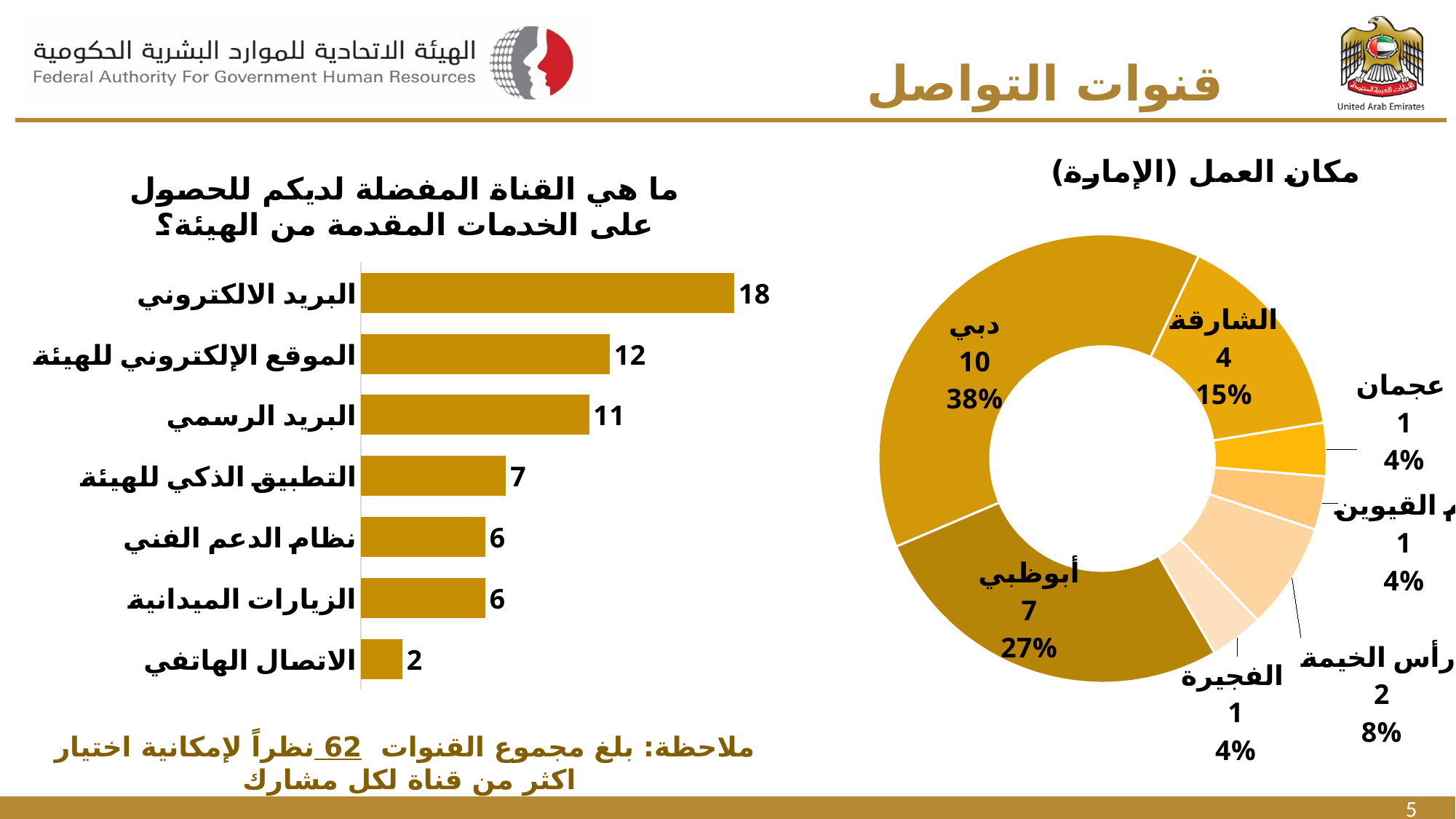
In the bar chart on the left, what is the difference between the values for الموقع الإلكتروني للهيئة and البريد الرسمي? 1 In the donut chart titled مكان العمل (الإمارة), what percentage share does دبي have? 38% In the bar chart on the left, which category has the highest value? البريد الالكتروني How many categories are shown in the bar chart on the left? 7 In the bar chart on the left, what is the value for البريد الالكتروني? 18 In the donut chart titled مكان العمل (الإمارة), what is the difference between the values for الشارقة and رأس الخيمة? 2 In the bar chart on the left, which is larger: the value for البريد الرسمي or the value for التطبيق الذكي للهيئة? البريد الرسمي In the bar chart on the left, which category has the lowest value? الاتصال الهاتفي In the donut chart titled مكان العمل (الإمارة), what is the value for أبوظبي? 7 What kind of chart is the chart on the left of the slide? bar chart In the bar chart on the left, what is the value for التطبيق الذكي للهيئة? 7 In the donut chart titled مكان العمل (الإمارة), which emirate has the largest share? دبي